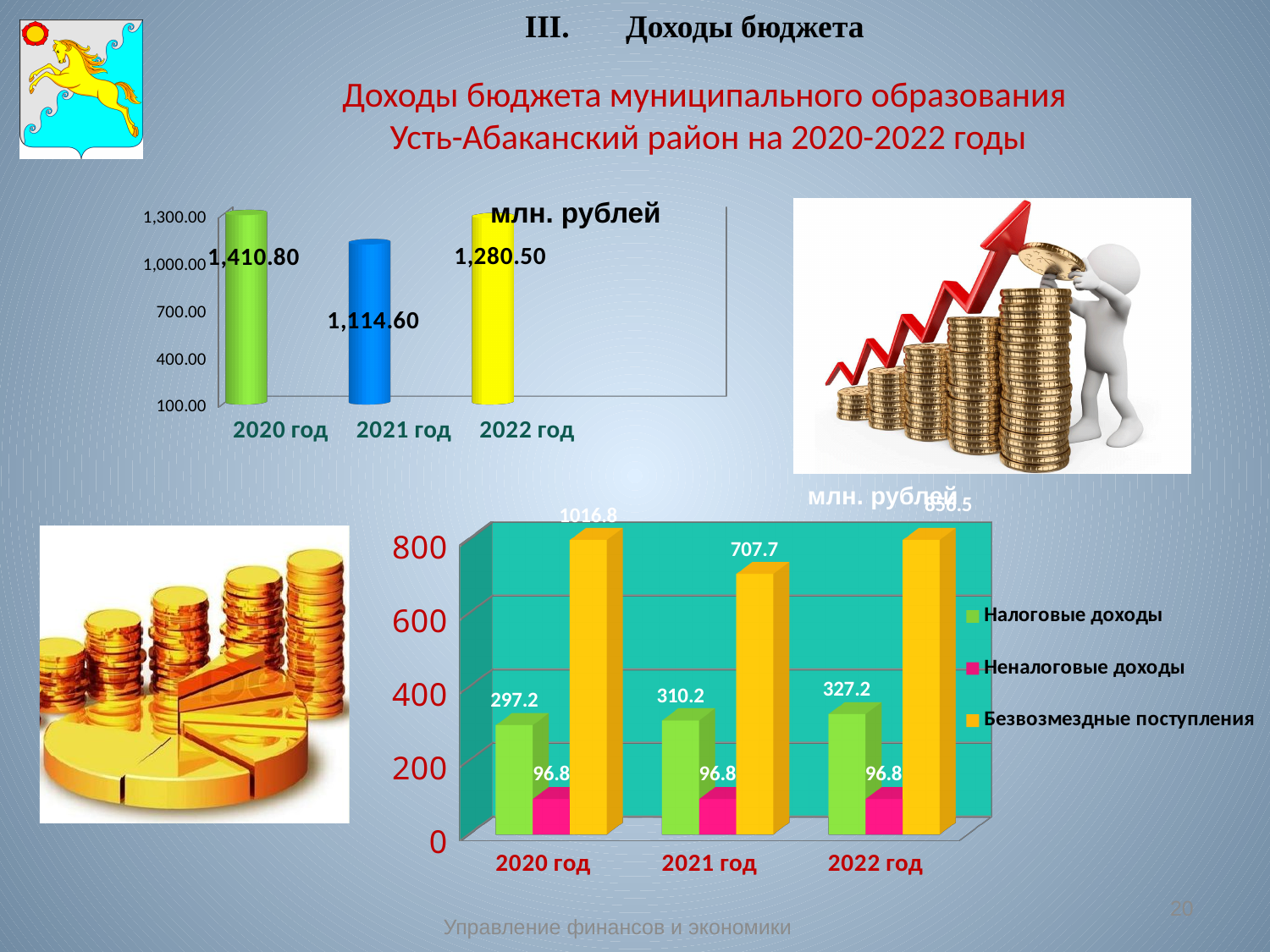
In the bottom chart, what is the value of Налоговые доходы for 2022 год? 327.2 In the top-left chart, what is the value for 2021 год? 1,114.60 In the bottom chart, what is the value of Безвозмездные поступления for 2021 год? 707.7 In the top-left chart, what is the difference between the values for 2020 год and 2021 год? 296.20 In the top-left chart, which year has the highest value? 2020 год In the top-left chart, which year has the lowest value? 2021 год In the bottom chart, how many series does the legend list? 3 In the bottom chart, what is the value of Неналоговые доходы for 2020 год? 96.8 In the top-left chart, how many years are shown? 3 In the top-left chart, what is the value for 2020 год? 1,410.80 In the top-left chart, what is the value for 2022 год? 1,280.50 In the bottom chart, do the values of Налоговые доходы rise or fall from 2020 год to 2022 год? rise